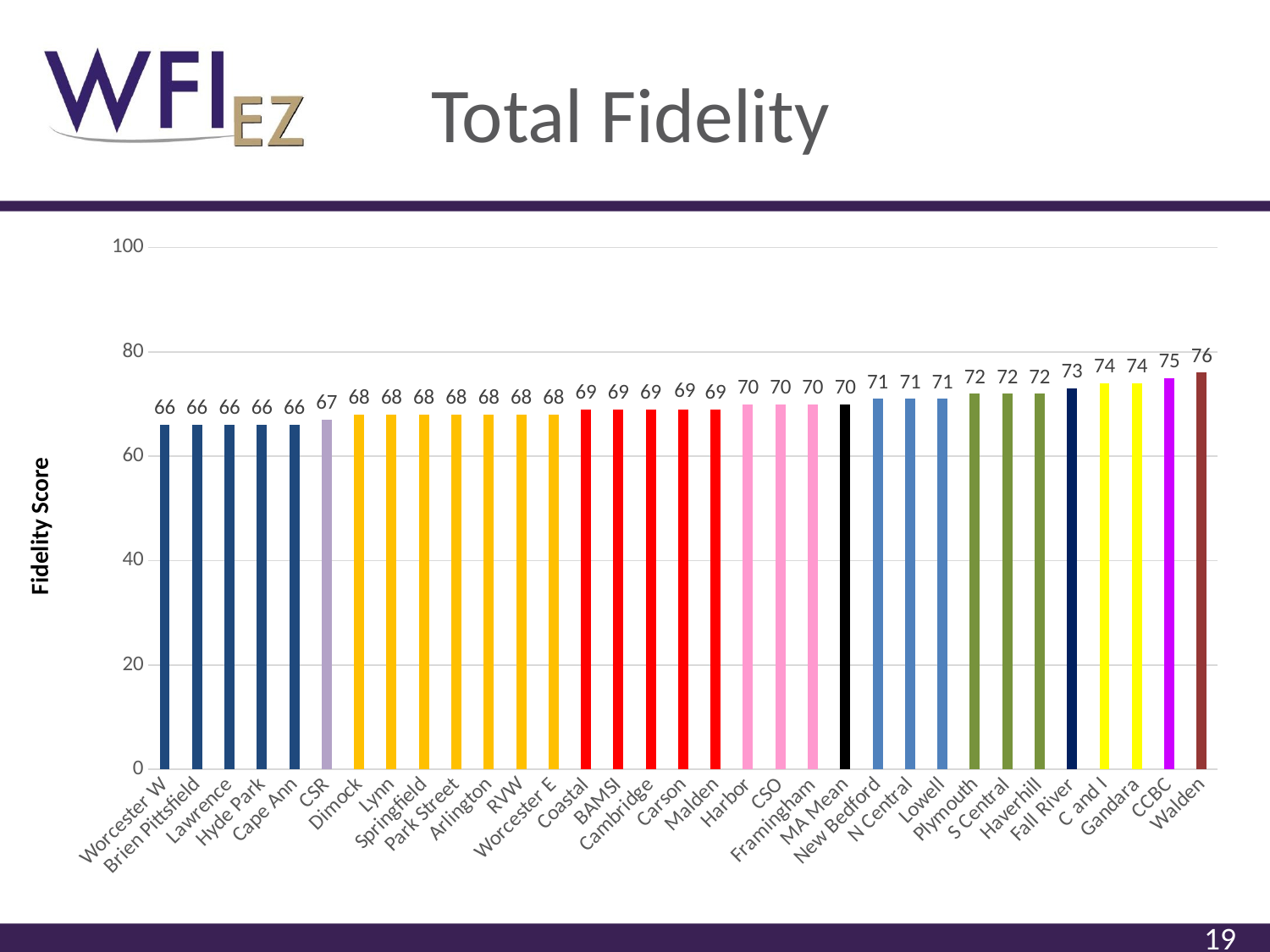
Which has a higher fidelity score, Gandara or Lynn? Gandara What is the difference between the fidelity scores of Walden and Worcester W? 10 Which site has the highest fidelity score? Walden What is the fidelity score for Walden? 76 Do the fidelity scores rise or fall from left to right across the chart? Rise What is the difference between the fidelity scores of CCBC and MA Mean? 5 What is the fidelity score for CSR? 67 What is the lowest fidelity score shown on the chart? 66 What type of chart is shown on the slide? Bar chart What is the fidelity score for MA Mean? 70 What is the fidelity score for Fall River? 73 How many sites (bars) are shown on the chart? 33